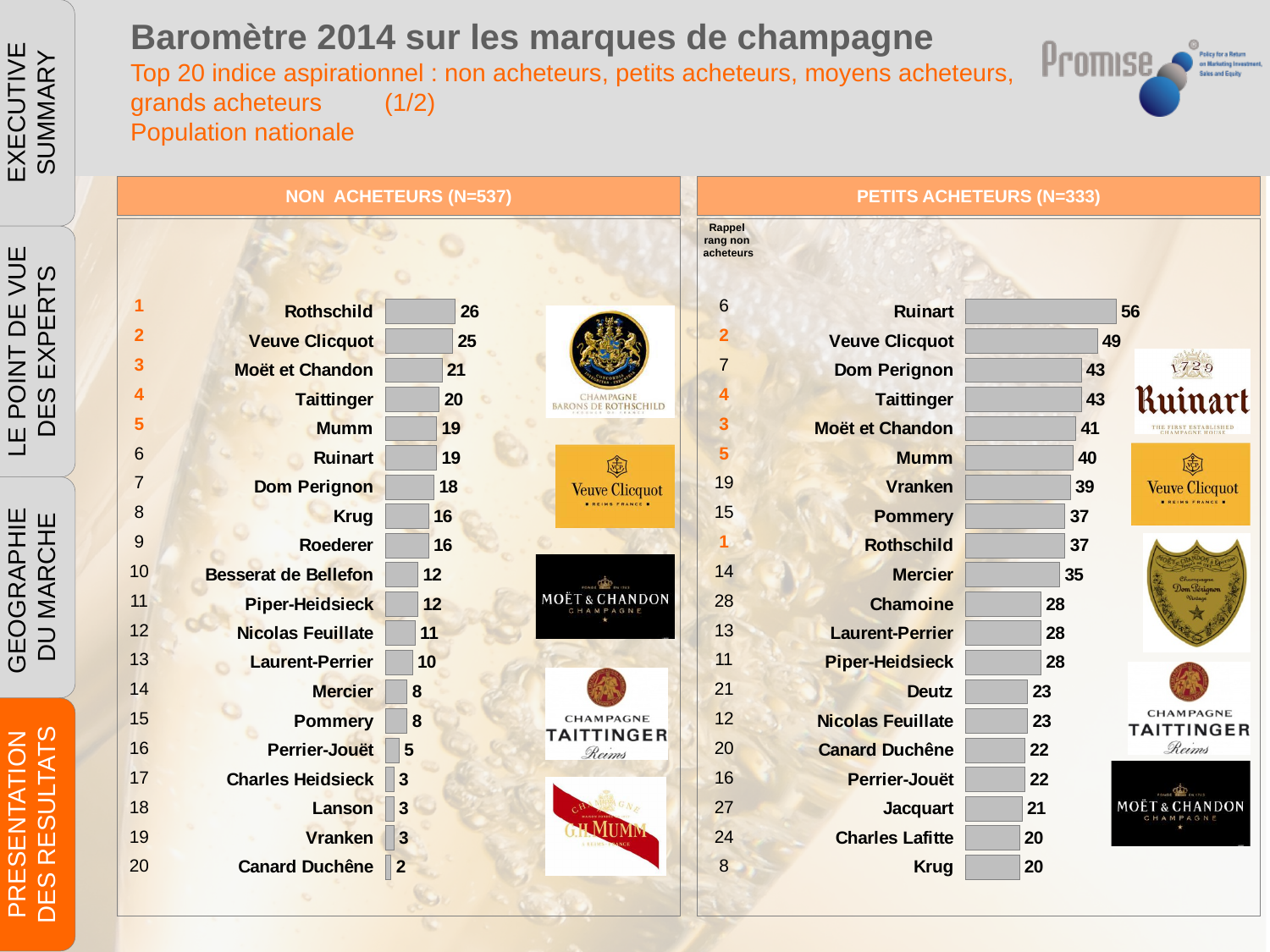
In the NON ACHETEURS (N=537) chart, how many brands are listed? 20 In the NON ACHETEURS (N=537) chart, what is the difference between Rothschild and Veuve Clicquot? 1 In the PETITS ACHETEURS (N=333) chart, what is the difference between Ruinart and Veuve Clicquot? 7 In the NON ACHETEURS (N=537) chart, which brand has the lowest value? Canard Duchêne In the PETITS ACHETEURS (N=333) chart, what is the value for Ruinart? 56 In the PETITS ACHETEURS (N=333) chart, which brand has the highest value? Ruinart What is the sample size (N) shown in the header of the NON ACHETEURS chart? 537 In the NON ACHETEURS (N=537) chart, what is the value for Rothschild? 26 In the NON ACHETEURS (N=537) chart, what is the value for Laurent-Perrier? 10 In the PETITS ACHETEURS (N=333) chart, which is larger, Vranken or Mercier? Vranken In the PETITS ACHETEURS (N=333) chart, what is the value for Jacquart? 21 What kind of chart is the PETITS ACHETEURS (N=333) chart? Bar chart